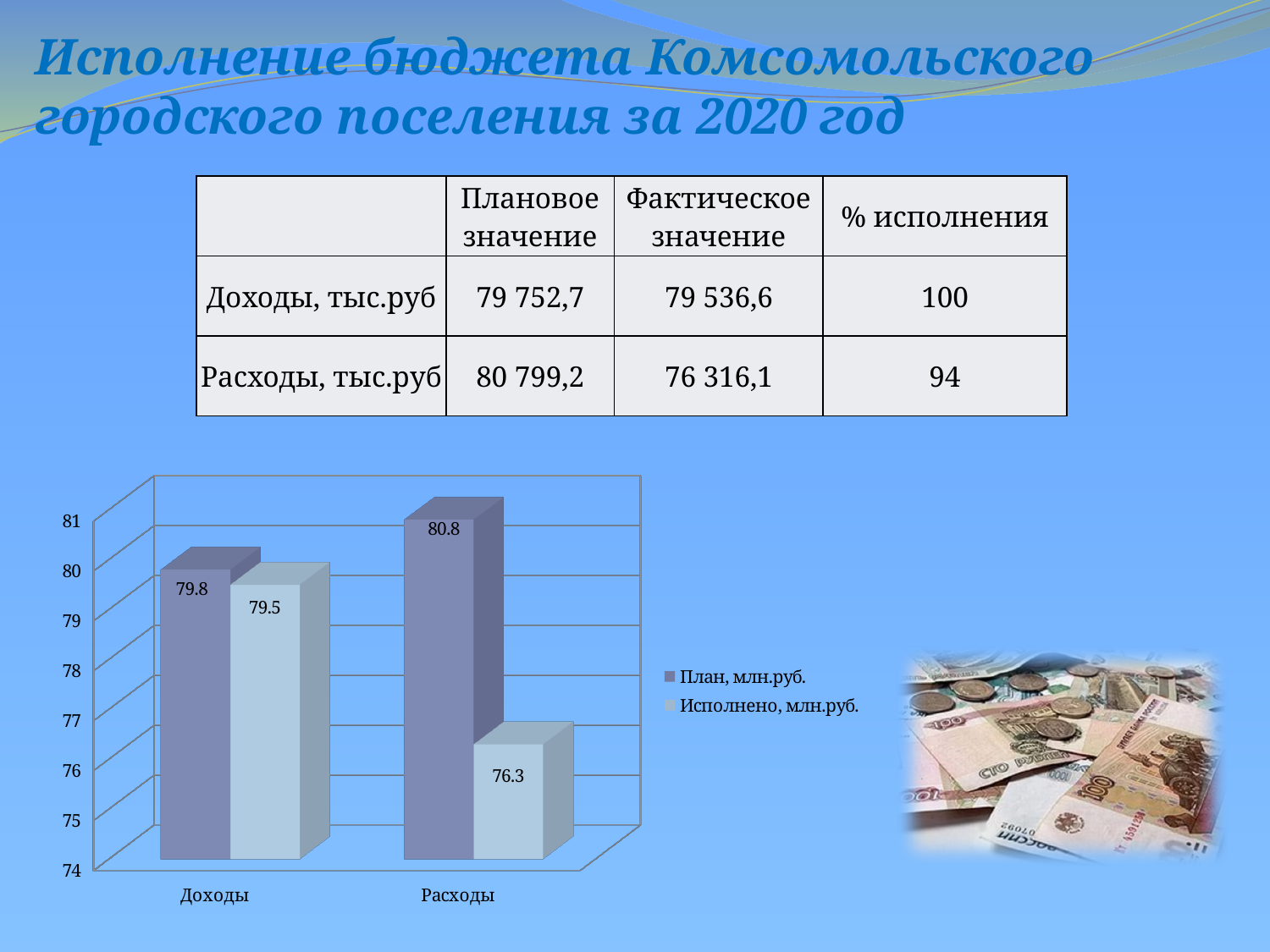
How many categories are shown on the x axis of the chart? 2 What is the value of Исполнено, млн.руб. for Доходы? 79.5 What is the value of План, млн.руб. for Расходы? 80.8 Which is larger for Доходы: План, млн.руб. or Исполнено, млн.руб.? План, млн.руб. Which category has the lowest Исполнено, млн.руб. value? Расходы What kind of chart is shown on the slide? Bar chart How many series does the chart legend list? 2 What is the value of Исполнено, млн.руб. for Расходы? 76.3 What is the difference between План, млн.руб. and Исполнено, млн.руб. for Расходы? 4.5 Which category has the highest План, млн.руб. value? Расходы What are the two series names listed in the chart legend? План, млн.руб. and Исполнено, млн.руб. What is the value of План, млн.руб. for Доходы? 79.8